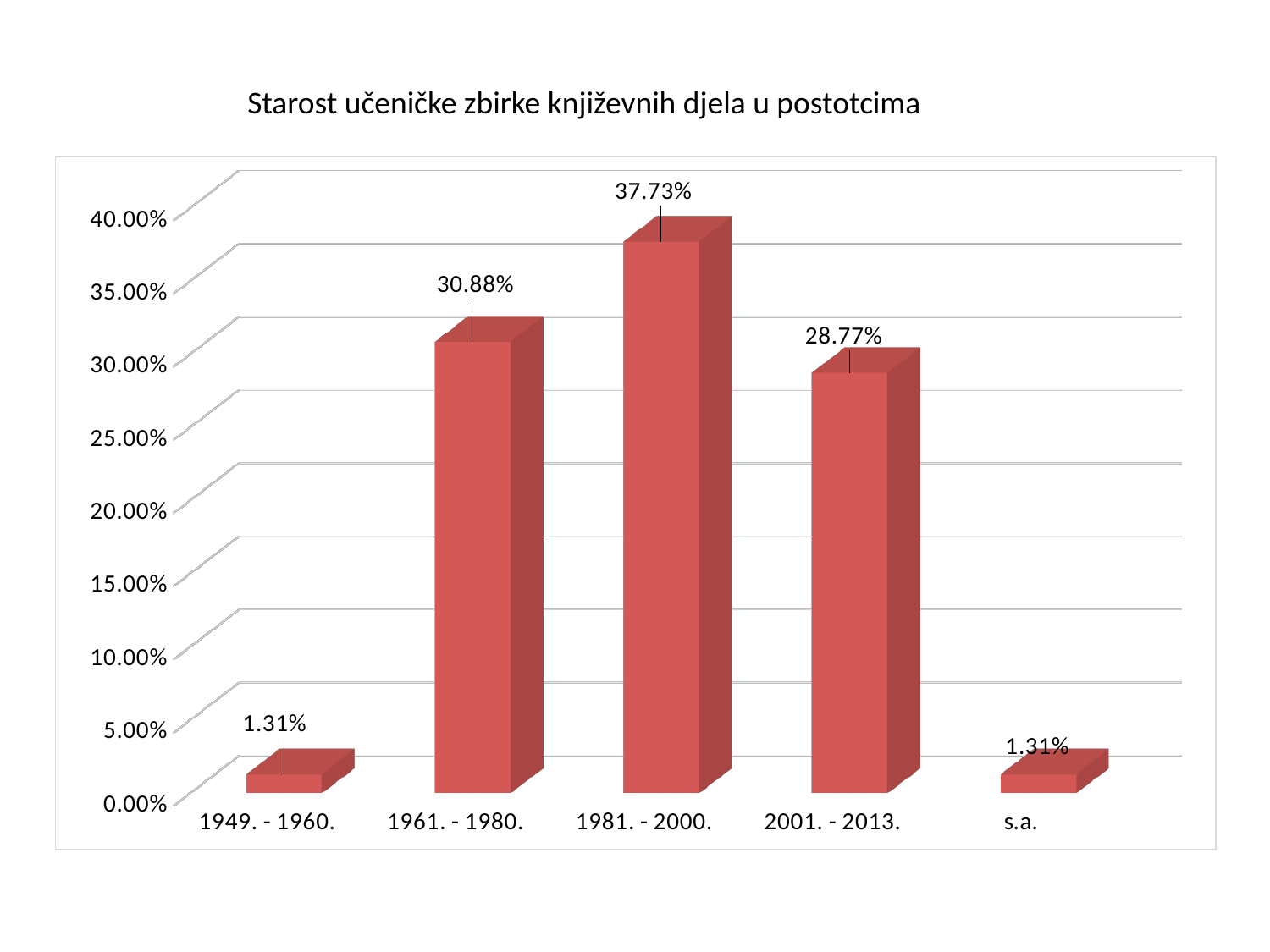
What is the difference between the values for 1961. - 1980. and 2001. - 2013.? 2.11% What is the value for s.a.? 1.31% What is the value for 2001. - 2013.? 28.77% Which category has the highest value? 1981. - 2000. What is the title of the chart? Starost učeničke zbirke književnih djela u postotcima How many categories are shown on the x axis? 5 Is the value for 2001. - 2013. greater or less than 25.00%? greater What is the value for 1981. - 2000.? 37.73% What kind of chart is shown on the slide? bar chart Which is larger, the value for 1961. - 1980. or the value for 2001. - 2013.? 1961. - 1980. What is the value for 1961. - 1980.? 30.88% What is the difference between the values for 1981. - 2000. and 1961. - 1980.? 6.85%